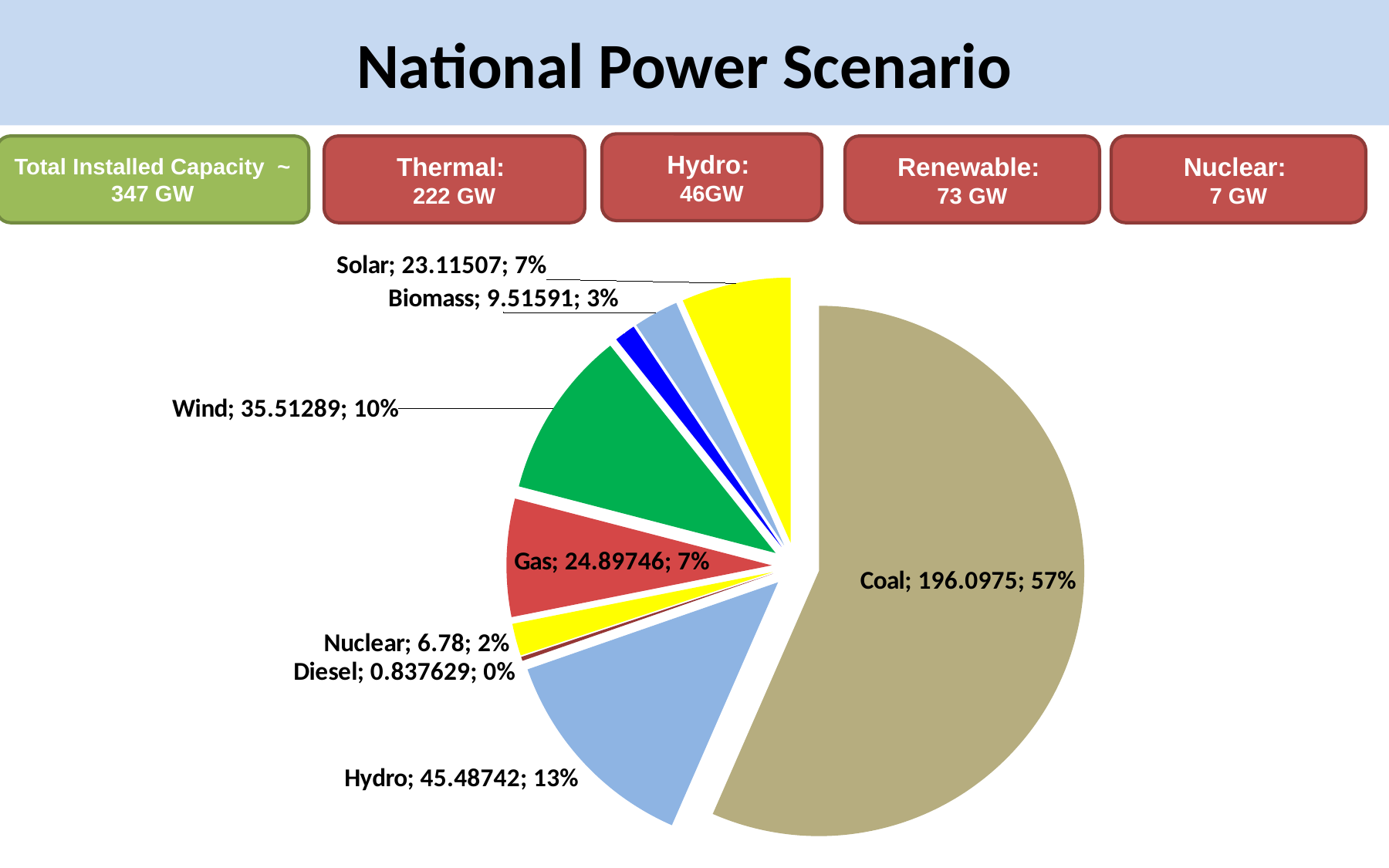
What percentage share does Nuclear have in the pie chart? 2% What percentage share does Solar have in the pie chart? 7% What percentage share does Hydro have in the pie chart? 13% What is the value shown for Coal in the pie chart? 196.0975 What is the title of the slide containing the pie chart? National Power Scenario What type of chart is shown on the slide? pie chart How many slices does the pie chart have? 9 Which is larger in the pie chart, Gas or Nuclear? Gas What is the value shown for Biomass in the pie chart? 9.51591 Which category has the smallest slice in the pie chart? Diesel What is the value shown for Wind in the pie chart? 35.51289 Which category has the largest slice in the pie chart? Coal